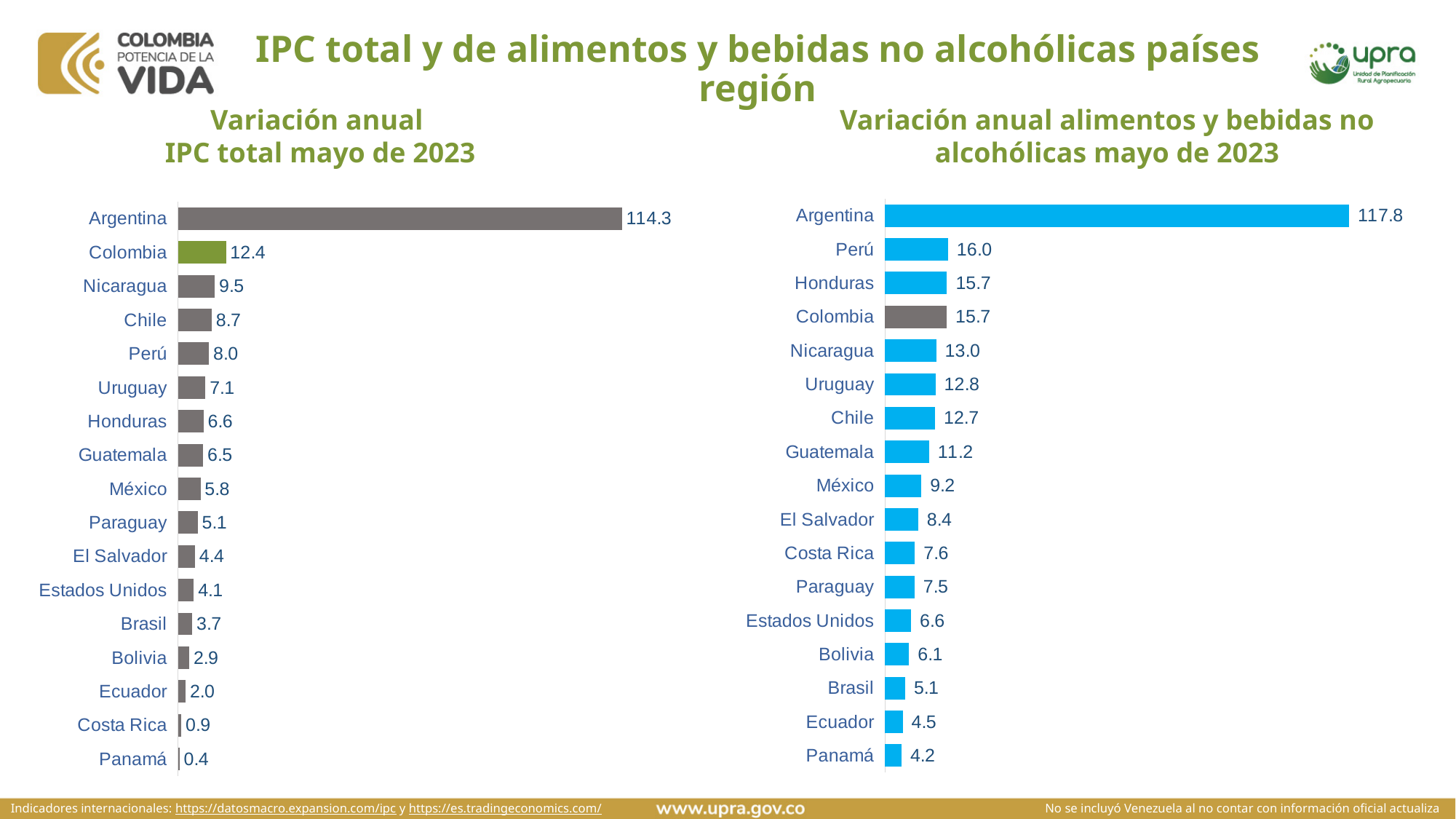
In the 'Variación anual IPC total mayo de 2023' chart, what is the difference between Argentina and Colombia? 101.9 In the 'Variación anual alimentos y bebidas no alcohólicas mayo de 2023' chart, which country's bar is coloured grey instead of blue? Colombia How many countries are shown in the 'Variación anual IPC total mayo de 2023' chart? 17 What kind of chart is the 'Variación anual alimentos y bebidas no alcohólicas mayo de 2023' chart? Bar chart In the 'Variación anual IPC total mayo de 2023' chart, which country has the highest value? Argentina In the 'Variación anual IPC total mayo de 2023' chart, which country has the lowest value? Panamá In the 'Variación anual IPC total mayo de 2023' chart, which is larger, the value for Chile or the value for Perú? Chile In the 'Variación anual alimentos y bebidas no alcohólicas mayo de 2023' chart, what is the difference between Nicaragua and México? 3.8 In the 'Variación anual alimentos y bebidas no alcohólicas mayo de 2023' chart, which country has the lowest value? Panamá In the 'Variación anual IPC total mayo de 2023' chart, what is the value for Colombia? 12.4 In the 'Variación anual alimentos y bebidas no alcohólicas mayo de 2023' chart, which is larger, the value for Brasil or the value for Bolivia? Bolivia In the 'Variación anual alimentos y bebidas no alcohólicas mayo de 2023' chart, what is the value for Perú? 16.0